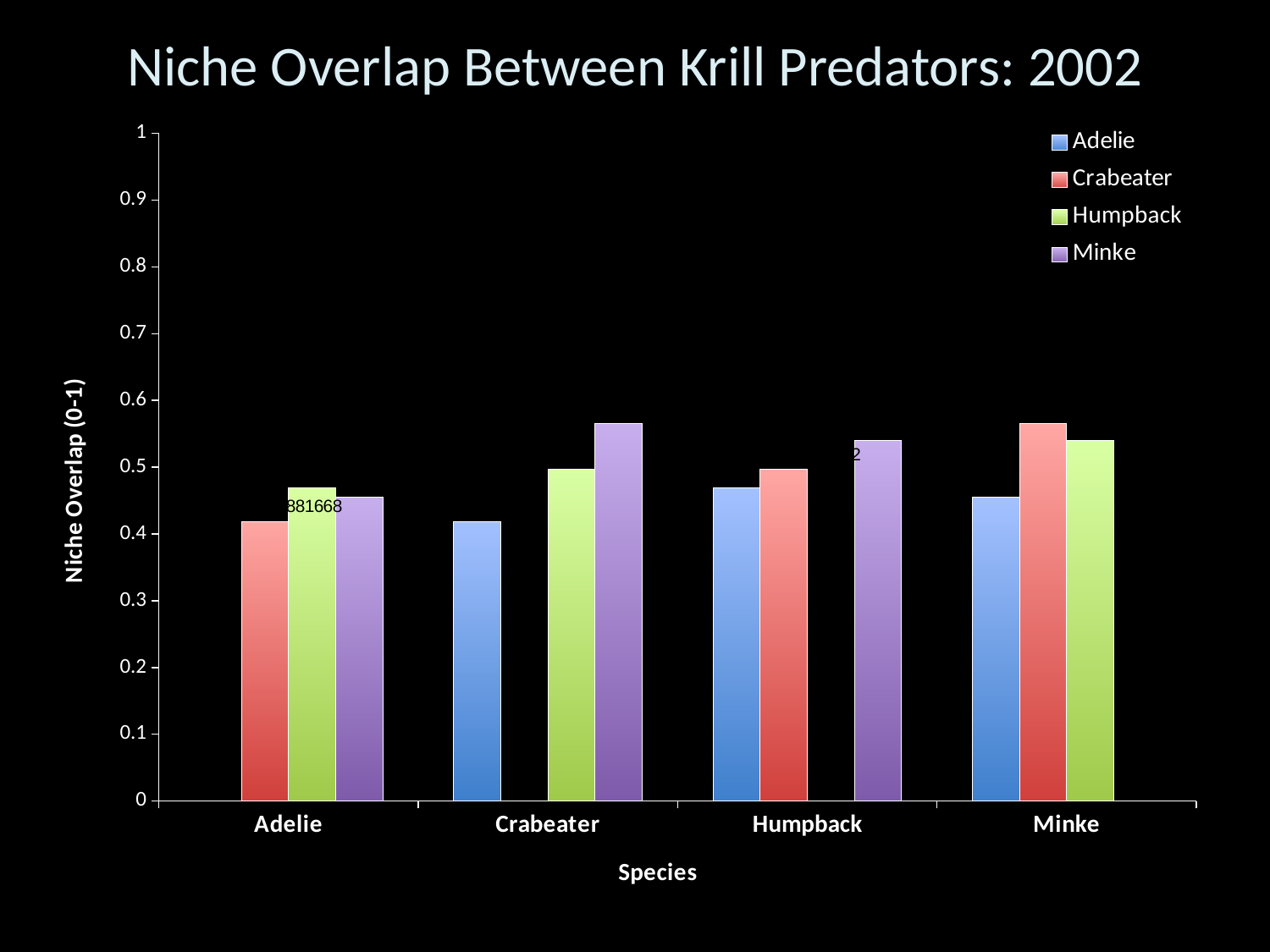
What kind of chart is shown on the slide? bar chart Is the value for the Crabeater series in the Minke category greater or less than 0.5? greater Within the Crabeater category, which series has the highest bar? Minke Is the value for the Crabeater series in the Adelie category greater or less than 0.5? less Within the Minke category, which series has the lowest bar? Adelie What is the title of the y axis? Niche Overlap (0-1) Within the Crabeater category, which series has the lowest bar? Adelie Is the value for the Minke series in the Crabeater category greater or less than 0.5? greater In the Crabeater category, which is larger: the Humpback bar or the Adelie bar? Humpback How many species categories are shown on the x axis? 4 How many series does the legend list? 4